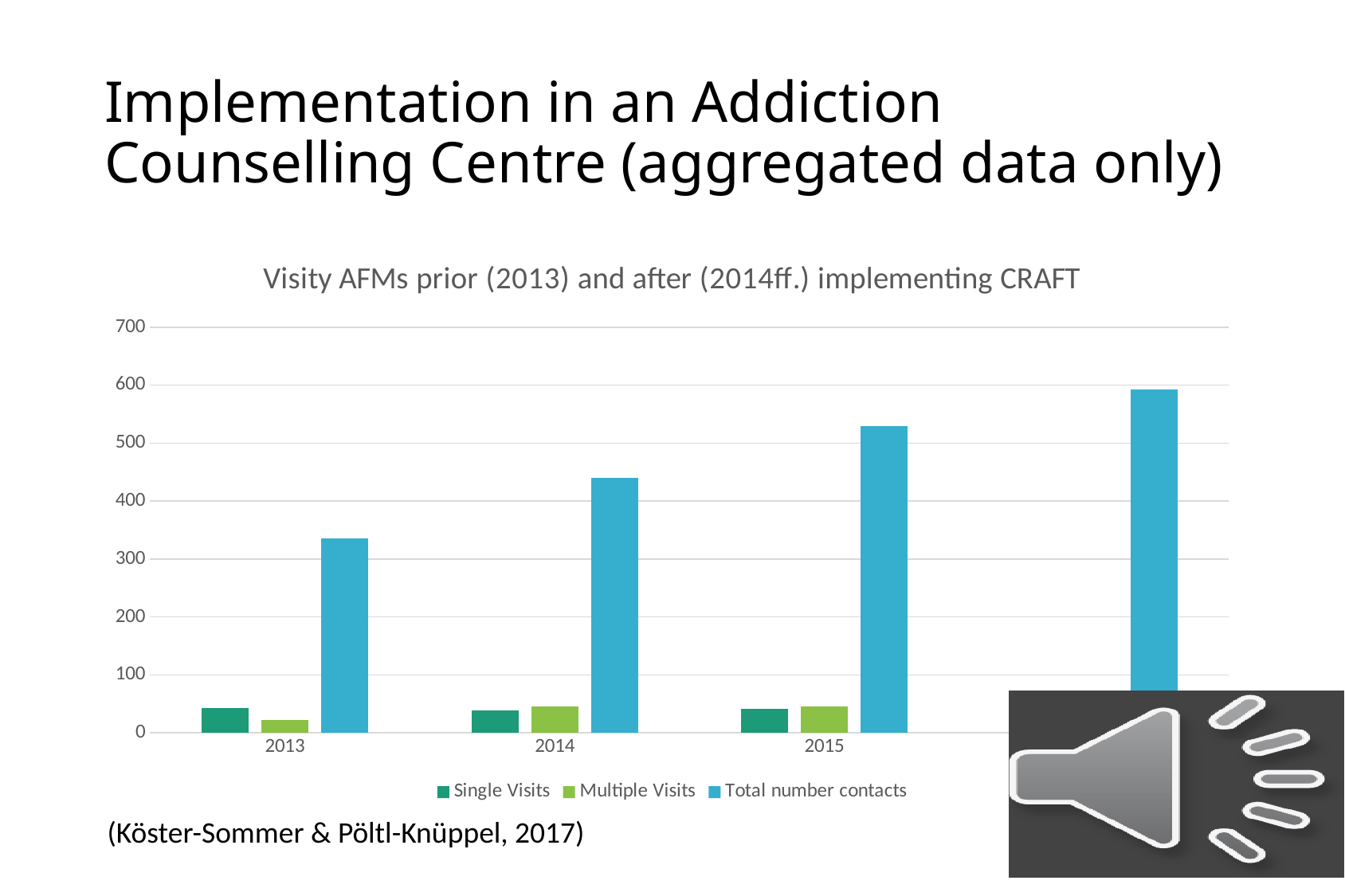
What is the title of the chart? Visity AFMs prior (2013) and after (2014ff.) implementing CRAFT How many series does the legend list? 3 Which year has the lowest value for Total number contacts? 2013 Do the values for Total number contacts rise or fall from left to right along the x axis? rise What kind of chart is shown on the slide? bar chart Is the value for Total number contacts in 2013 greater or less than 300? greater Is the value for Total number contacts in 2014 greater or less than 400? greater Is the value for Multiple Visits in 2013 greater or less than 100? less How many groups of bars are plotted in the chart? 4 Among 2013, 2014 and 2015, which year has the highest value for Total number contacts? 2015 In 2013, which is larger: Single Visits or Multiple Visits? Single Visits